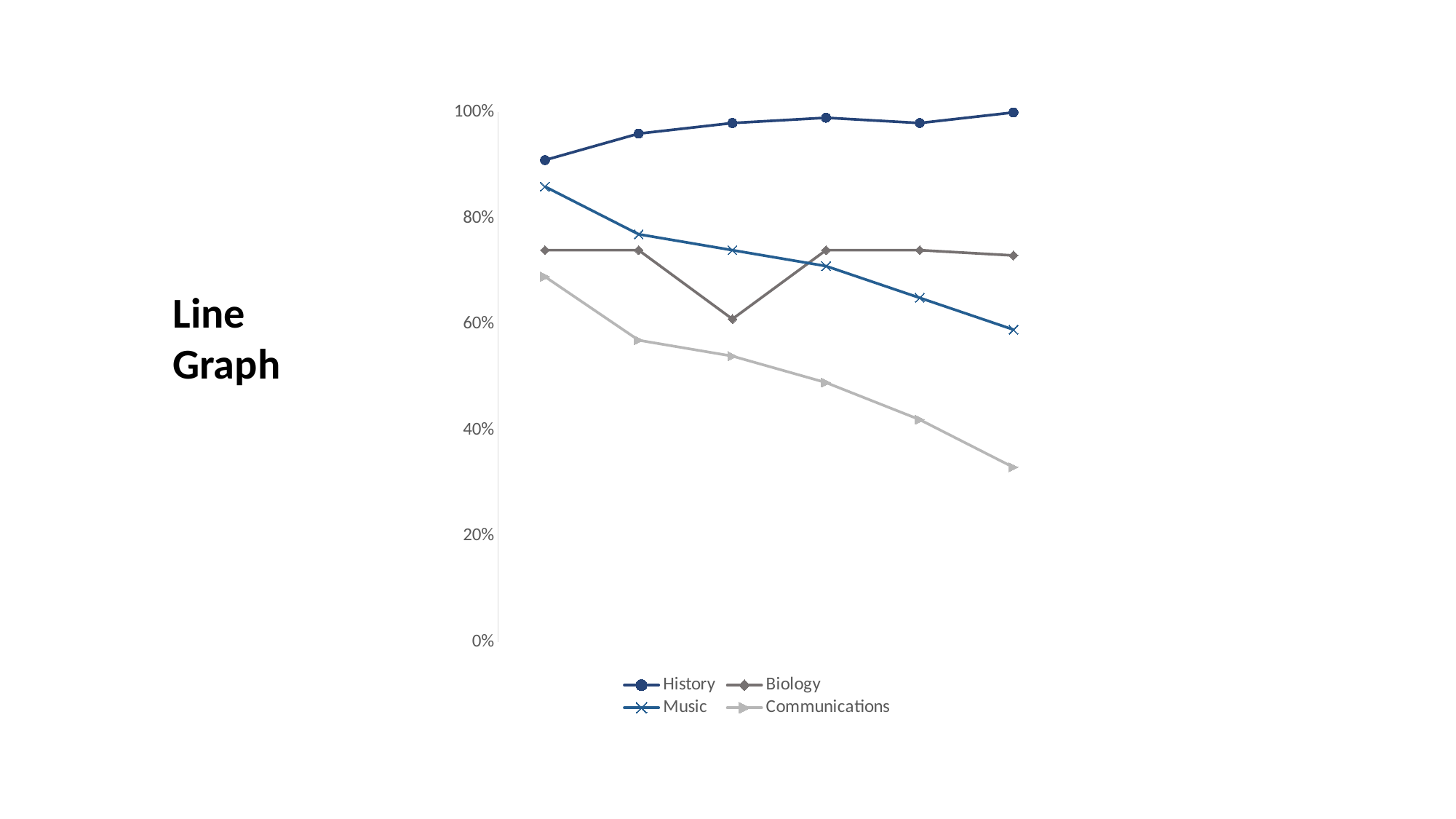
How many series does the legend list? 4 Is the last value for Communications greater or less than 40%? less Do the values for Communications rise or fall from left to right? fall At the last point, which is larger, Biology or Music? Biology Which series is drawn with x-shaped markers? Music Which series has the highest values across the chart? History Do the values for History generally rise or fall from left to right? rise Is the first value for History greater or less than 80%? greater How many data points does the History line have? 6 What kind of chart is shown on the slide? line chart Which series has the lowest values across the chart? Communications Do the values for Music rise or fall from left to right? fall